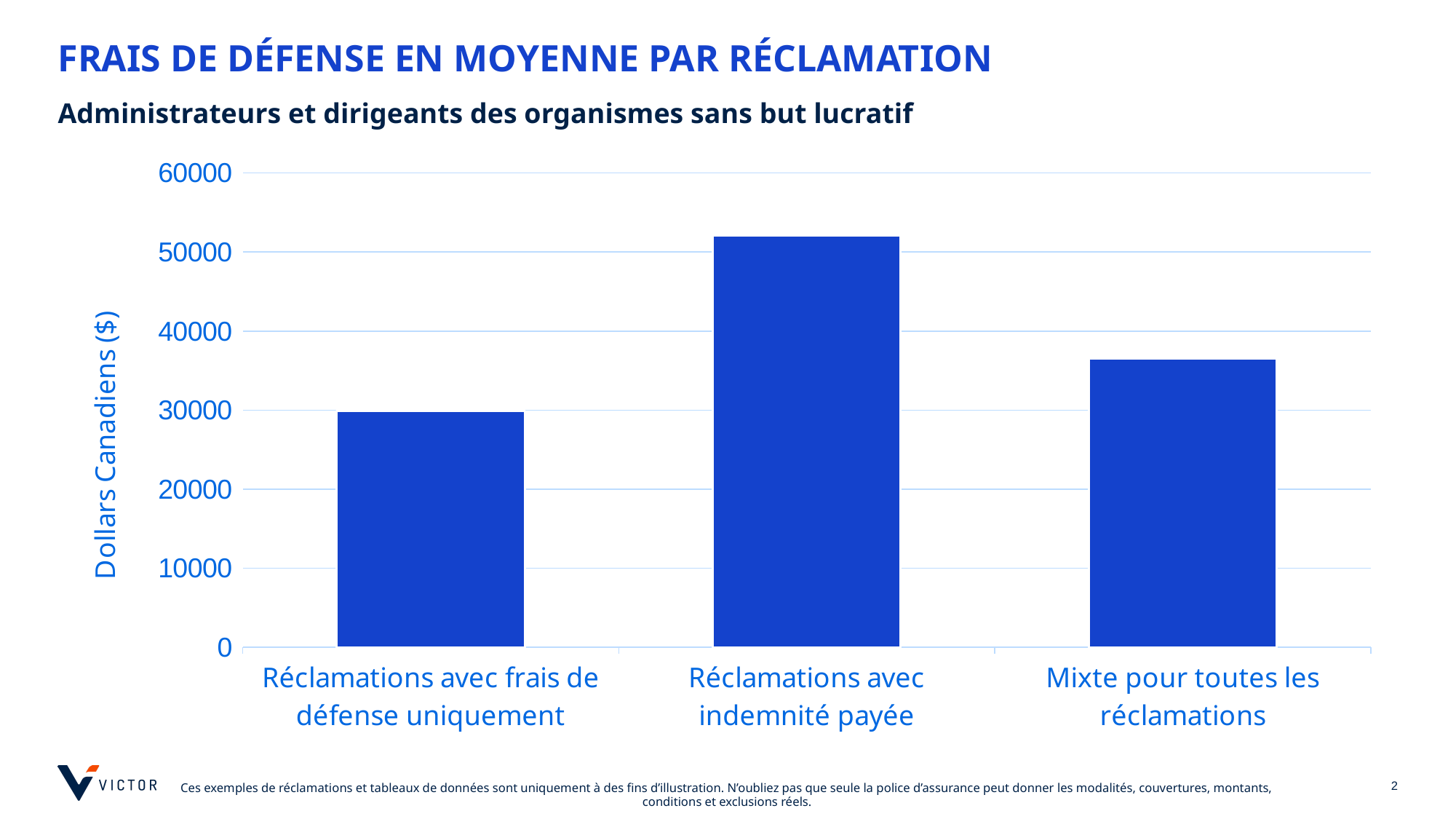
Is the value for 'Réclamations avec frais de défense uniquement' greater or less than 40000? less Which is larger: the value for 'Réclamations avec indemnité payée' or the value for 'Mixte pour toutes les réclamations'? Réclamations avec indemnité payée What is the label of the vertical axis of the chart? Dollars Canadiens ($) Is the value for 'Réclamations avec indemnité payée' greater or less than 50000? greater Is the value for 'Mixte pour toutes les réclamations' greater or less than 30000? greater What is the title of the chart on the slide? FRAIS DE DÉFENSE EN MOYENNE PAR RÉCLAMATION Which is larger: the value for 'Mixte pour toutes les réclamations' or the value for 'Réclamations avec frais de défense uniquement'? Mixte pour toutes les réclamations How many categories are shown on the x axis of the chart? 3 Which category has the highest average defence cost? Réclamations avec indemnité payée What kind of chart is shown on the slide? bar chart Which category has the lowest average defence cost? Réclamations avec frais de défense uniquement